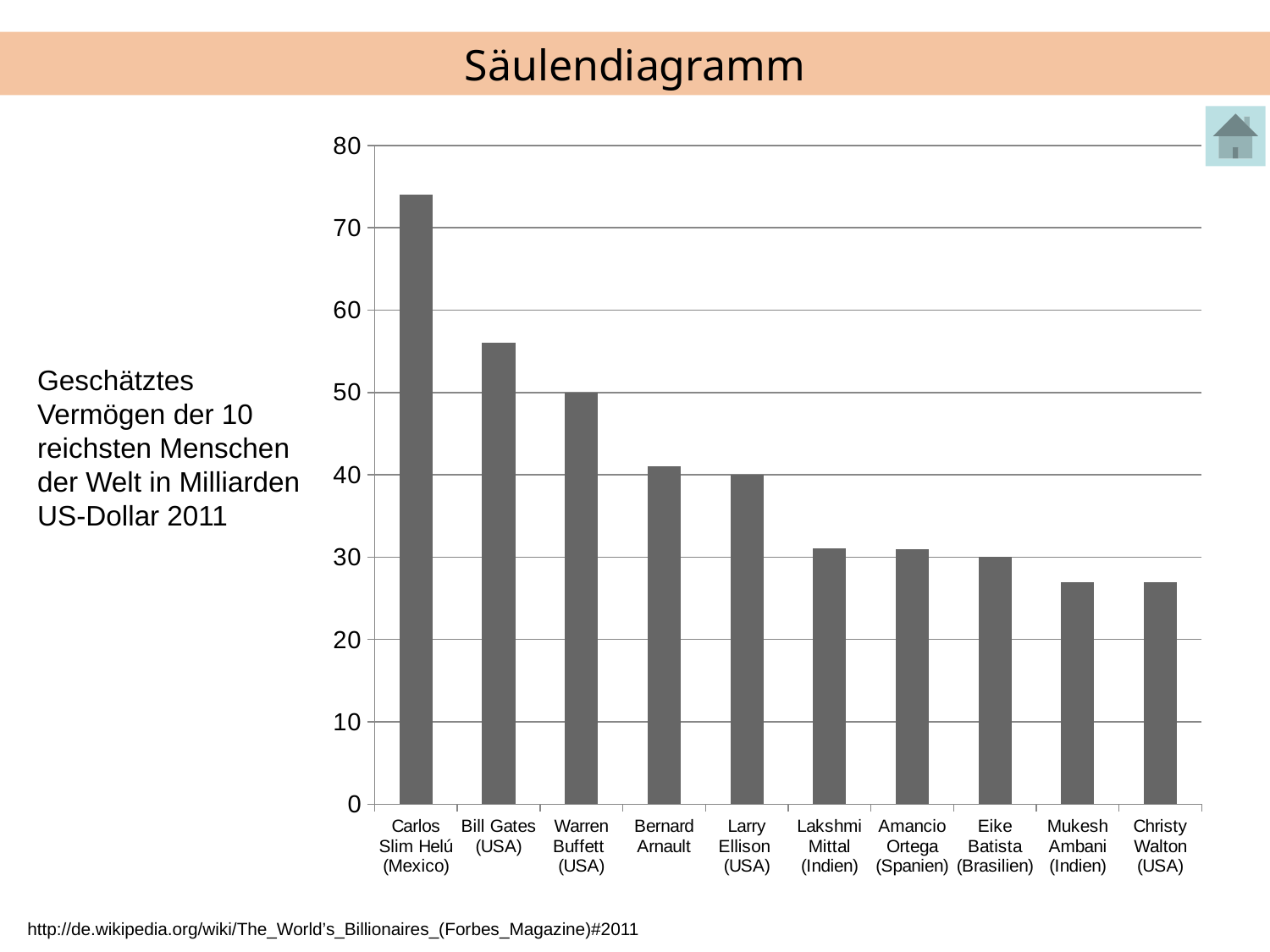
What is the value for Warren Buffett (USA)? 50 Which is larger, the value for Warren Buffett (USA) or the value for Larry Ellison (USA)? Warren Buffett (USA) Do the values rise or fall from left to right along the x axis? fall What is the value for Larry Ellison (USA)? 40 What is the title shown at the top of the slide? Säulendiagramm Which person has the highest value in the chart? Carlos Slim Helú (Mexico) Is the value for Carlos Slim Helú (Mexico) greater or less than 70? greater How many people (categories) are shown in the chart? 10 Is the value for Mukesh Ambani (Indien) greater or less than 30? less Is the value for Christy Walton (USA) greater or less than 30? less What kind of chart is shown on the slide? bar chart